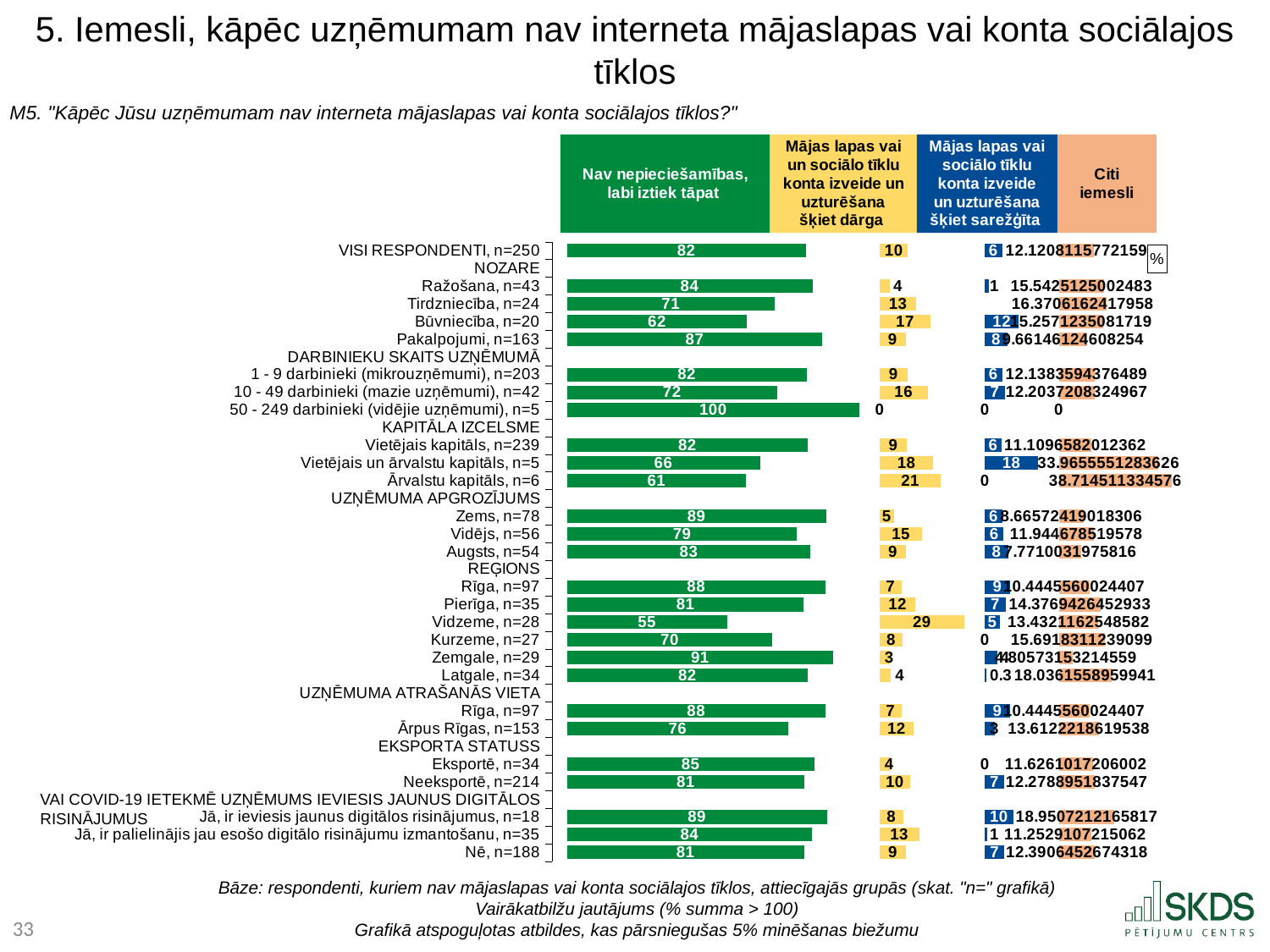
Among the REĢIONS categories (Rīga, Pierīga, Vidzeme, Kurzeme, Zemgale, Latgale), which has the highest value for "Nav nepieciešamības, labi iztiek tāpat"? Zemgale, n=29 What is the value for "Nav nepieciešamības, labi iztiek tāpat" for VISI RESPONDENTI, n=250? 82 How many series does the chart legend list? 4 Among the REĢIONS categories (Rīga, Pierīga, Vidzeme, Kurzeme, Zemgale, Latgale), which has the lowest value for "Nav nepieciešamības, labi iztiek tāpat"? Vidzeme, n=28 What is the difference between the "šķiet dārga" values for Būvniecība, n=20 and Ražošana, n=43? 13 What colour represents the "Citi iemesli" series? Orange What is the difference between the "Nav nepieciešamības, labi iztiek tāpat" values for Rīga, n=97 and Ārpus Rīgas, n=153? 12 What is the value for "Mājas lapas vai un sociālo tīklu konta izveide un uzturēšana šķiet dārga" for Vidzeme, n=28? 29 What is the value for "Nav nepieciešamības, labi iztiek tāpat" for 50 - 249 darbinieki (vidējie uzņēmumi), n=5? 100 Among the NOZARE categories, which has the highest value for "Mājas lapas vai un sociālo tīklu konta izveide un uzturēšana šķiet dārga"? Būvniecība, n=20 Which has the larger value for "Nav nepieciešamības, labi iztiek tāpat": Eksportē, n=34 or Neeksportē, n=214? Eksportē, n=34 What type of chart is shown on the slide? Bar chart